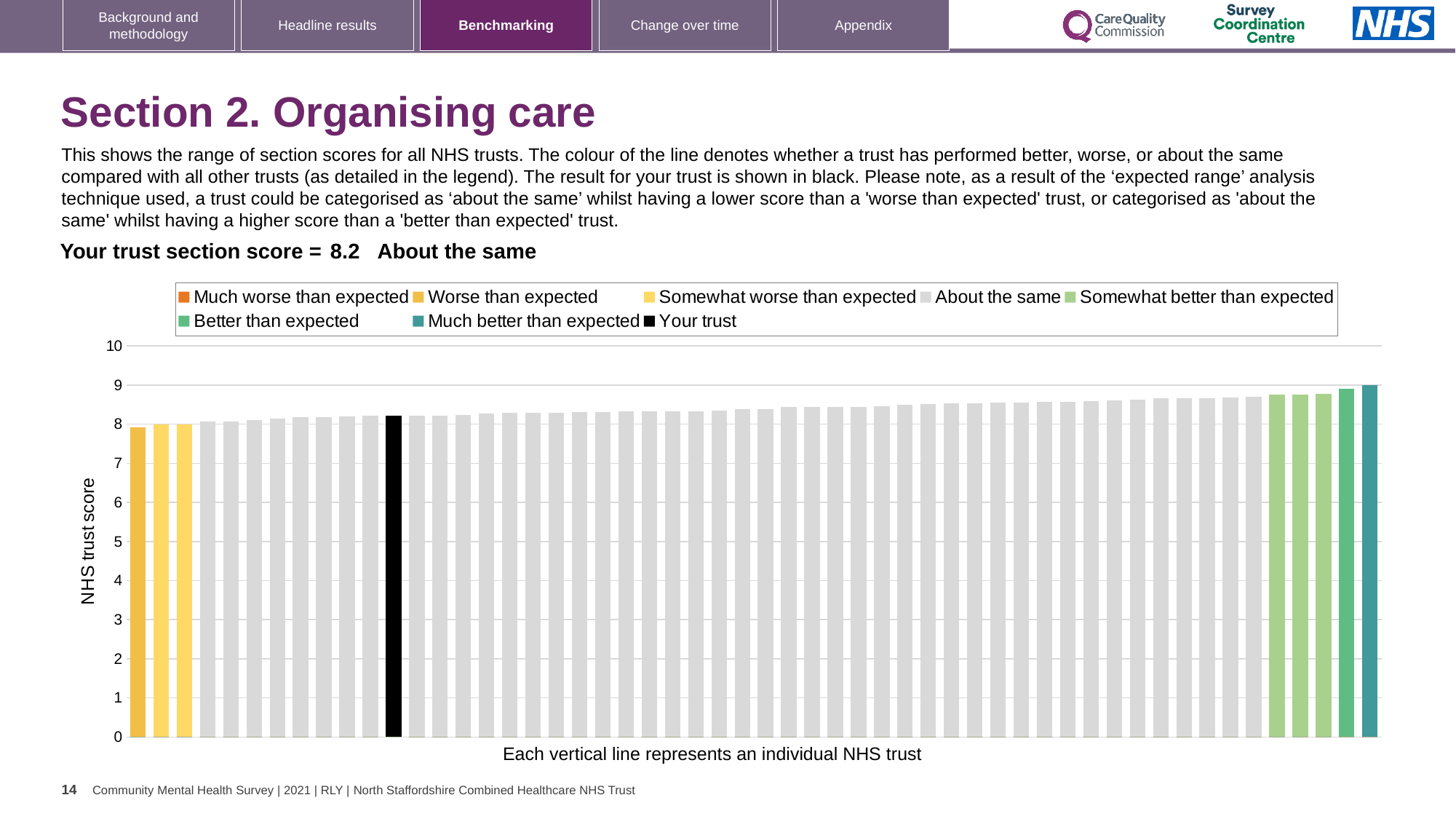
How is your trust's section score categorised compared with other trusts? About the same What is the section score for your trust? 8.2 Is the value for your trust greater or less than 9? less How many entries does the chart legend list? 8 Which legend category do the shortest bars belong to? Worse than expected Do the bar values rise or fall from left to right along the x axis? rise What colour is the bar representing your trust? black Which legend category does the tallest bar belong to? Much better than expected Is the value for the highest-scoring trust greater or less than 8? greater Is the value for your trust greater or less than 8? greater What is the label on the y axis? NHS trust score What kind of chart is shown on the slide? bar chart